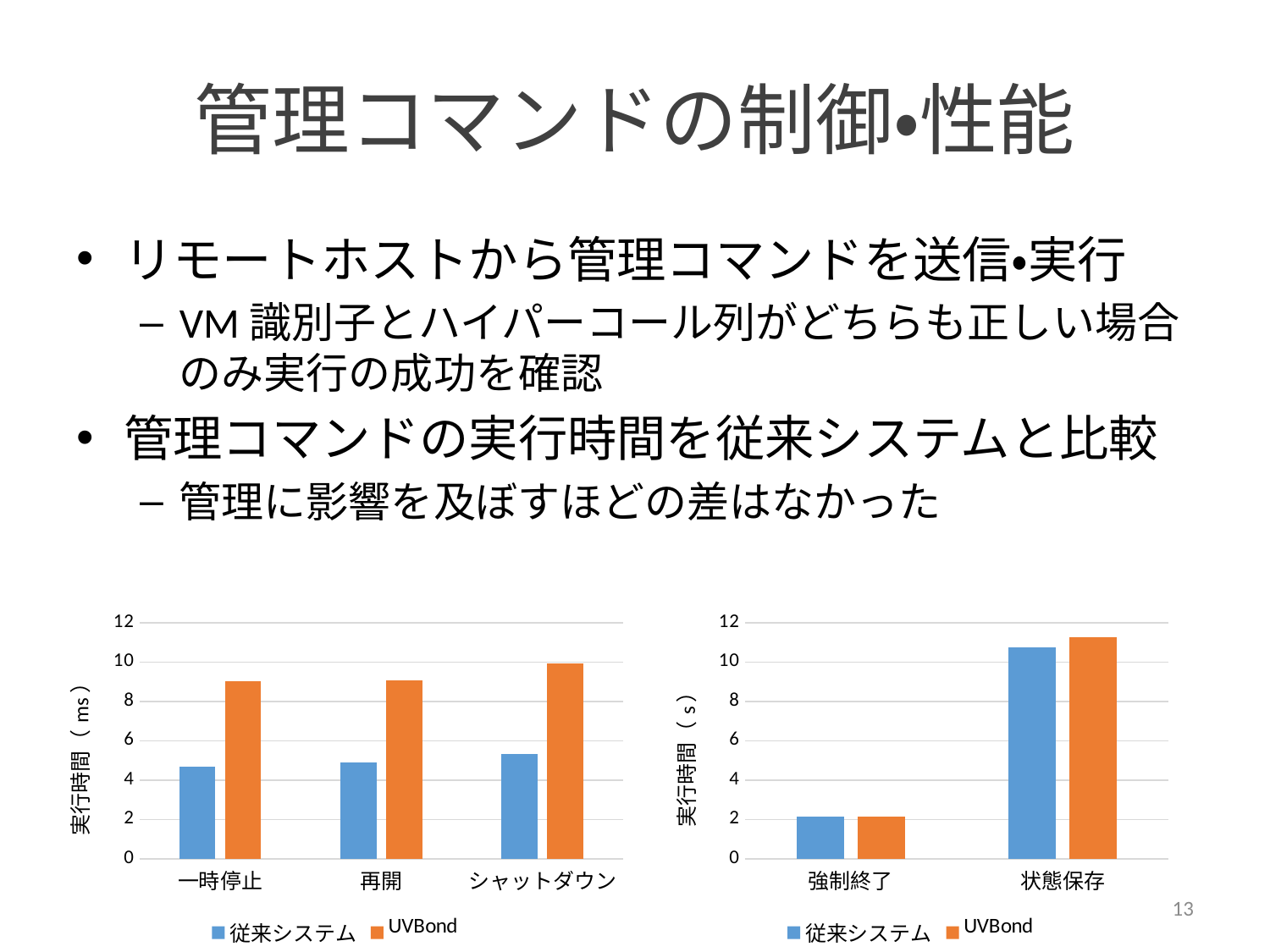
In the left chart (実行時間 in ms), is the 従来システム value for シャットダウン greater or less than 6? less In the right chart (実行時間 in s), is the UVBond value for 強制終了 greater or less than 4? less In the right chart (実行時間 in s), which category has the highest 従来システム value? 状態保存 What kind of chart is the left chart (実行時間 in ms)? bar chart In the left chart (実行時間 in ms), is the UVBond value for 一時停止 greater or less than 8? greater How many categories are shown on the x axis of the right chart (実行時間 in s)? 2 How many series does the legend of the left chart (実行時間 in ms) list? 2 How many categories are shown on the x axis of the left chart (実行時間 in ms)? 3 What is the y-axis label of the right chart? 実行時間（s） In the left chart (実行時間 in ms), which category has the highest UVBond value? シャットダウン In the left chart (実行時間 in ms), which is larger for 再開: 従来システム or UVBond? UVBond